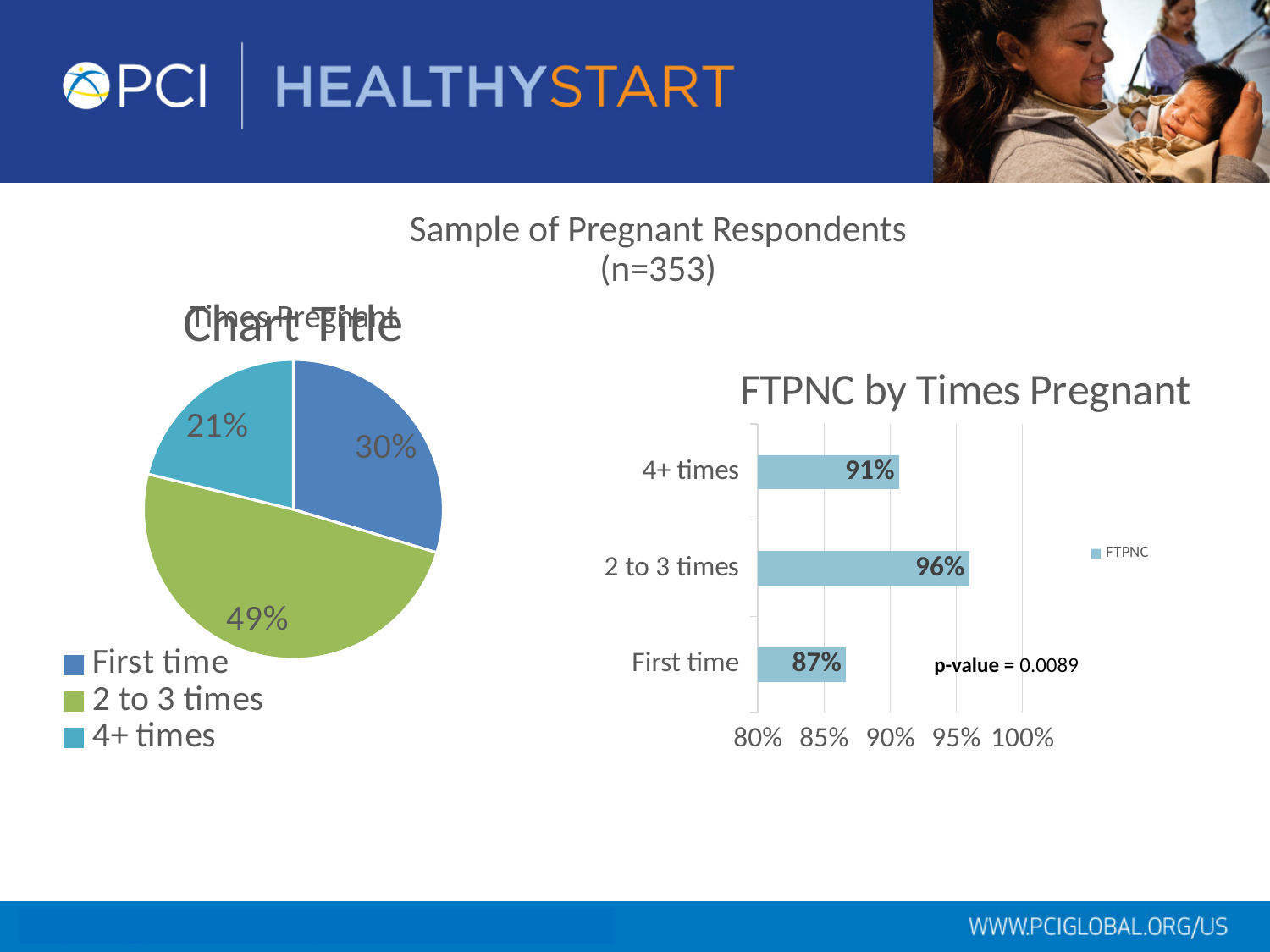
In the pie chart on the left, what percentage of respondents have been pregnant 2 to 3 times? 49% In the 'FTPNC by Times Pregnant' chart, what is the value for '2 to 3 times'? 96% In the pie chart on the left, which category has the smallest slice? 4+ times In the 'FTPNC by Times Pregnant' chart, what is the difference between the values for '2 to 3 times' and 'First time'? 9% In the 'FTPNC by Times Pregnant' chart, which category has the highest value? 2 to 3 times What kind of chart is 'FTPNC by Times Pregnant'? Bar chart In the pie chart on the left, which category has the largest slice? 2 to 3 times In the 'FTPNC by Times Pregnant' chart, which is larger, the value for '4+ times' or the value for 'First time'? 4+ times In the 'FTPNC by Times Pregnant' chart, what is the value for 'First time'? 87% In the pie chart on the left, what share of respondents are pregnant for the first time? 30% What p-value is shown on the 'FTPNC by Times Pregnant' chart? 0.0089 In the pie chart on the left, how many categories does the legend list? 3